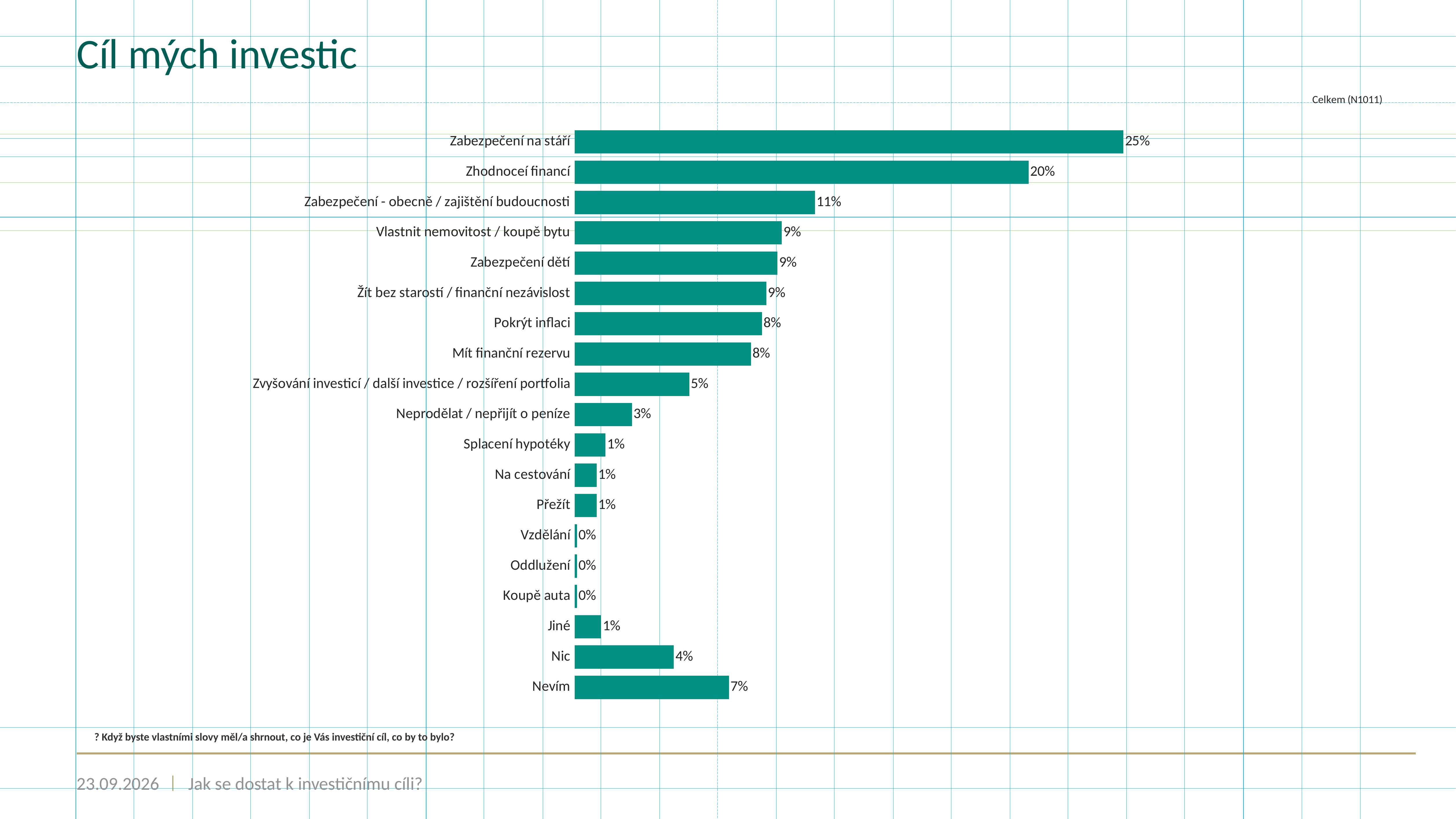
What is the difference between Zabezpečení na stáří and Zhodnoceí financí? 5% Which is larger, Zabezpečení - obecně / zajištění budoucnosti or Pokrýt inflaci? Zabezpečení - obecně / zajištění budoucnosti What is the value for Nevím? 7% What is the value for Zvyšování investicí / další investice / rozšíření portfolia? 5% How many categories are shown in the chart? 19 Which category has the highest value? Zabezpečení na stáří What is the value for Zhodnoceí financí? 20% What kind of chart is shown on the slide? bar chart What is the value for Neprodělat / nepřijít o peníze? 3% What is the value for Zabezpečení na stáří? 25% Which is larger, Nic or Nevím? Nevím What is the title of the slide? Cíl mých investic